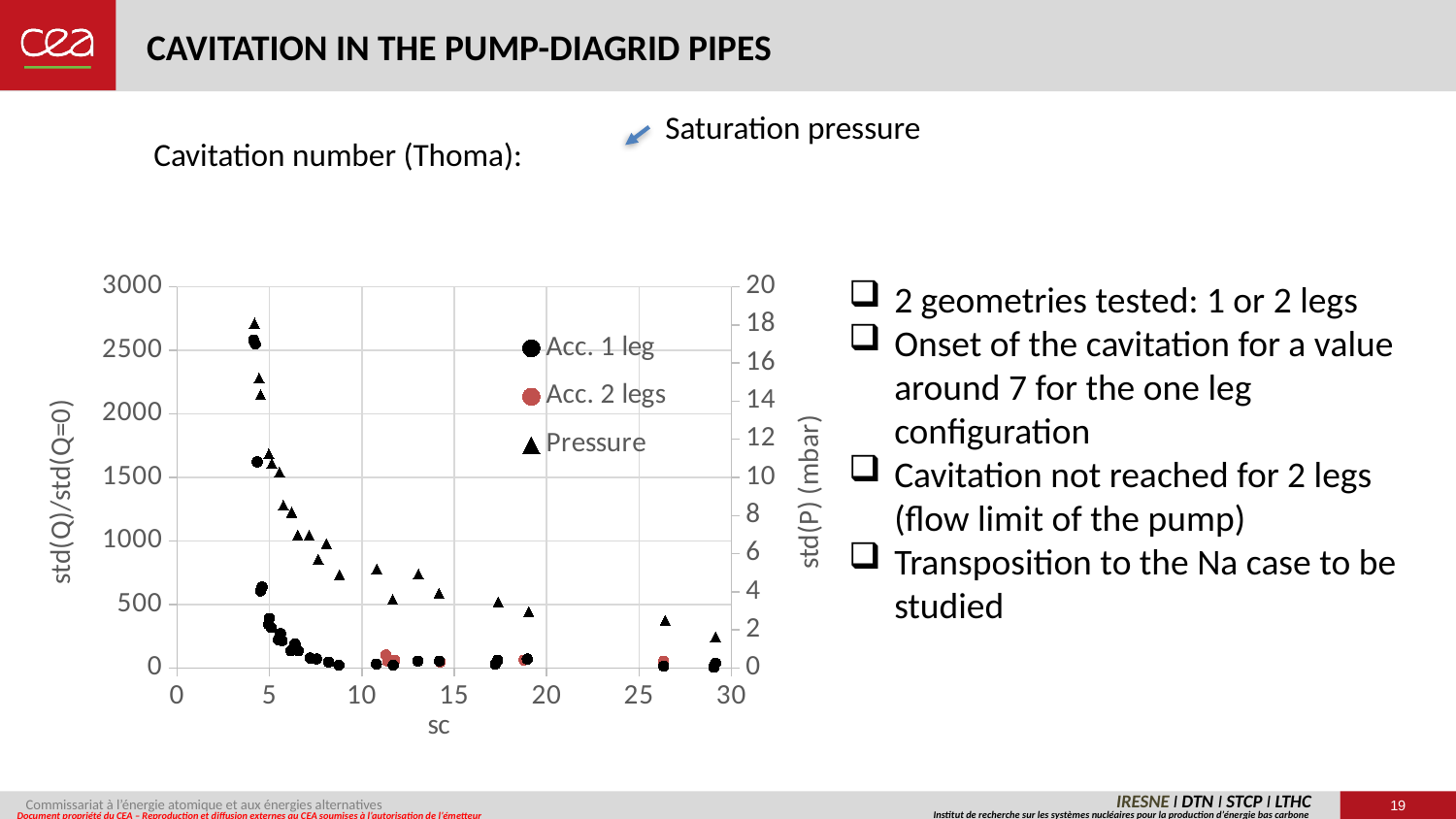
Do the Acc. 1 leg values rise or fall as sc increases? fall Do the Pressure values rise or fall as sc increases? fall What are the three series named in the chart legend? Acc. 1 leg, Acc. 2 legs, Pressure What kind of chart is shown on the slide? scatter chart Is the highest Acc. 1 leg value on the left axis greater or less than 2000? greater Is the Pressure value at sc near 29 greater or less than 4 on the right axis? less Which series reaches the highest value on the left axis, Acc. 1 leg or Acc. 2 legs? Acc. 1 leg How many series does the chart legend list? 3 What is the maximum value shown on the right y axis of the chart? 20 Is the Acc. 1 leg value at sc near 29 greater or less than 500 on the left axis? less What is the label of the x axis of the chart? sc